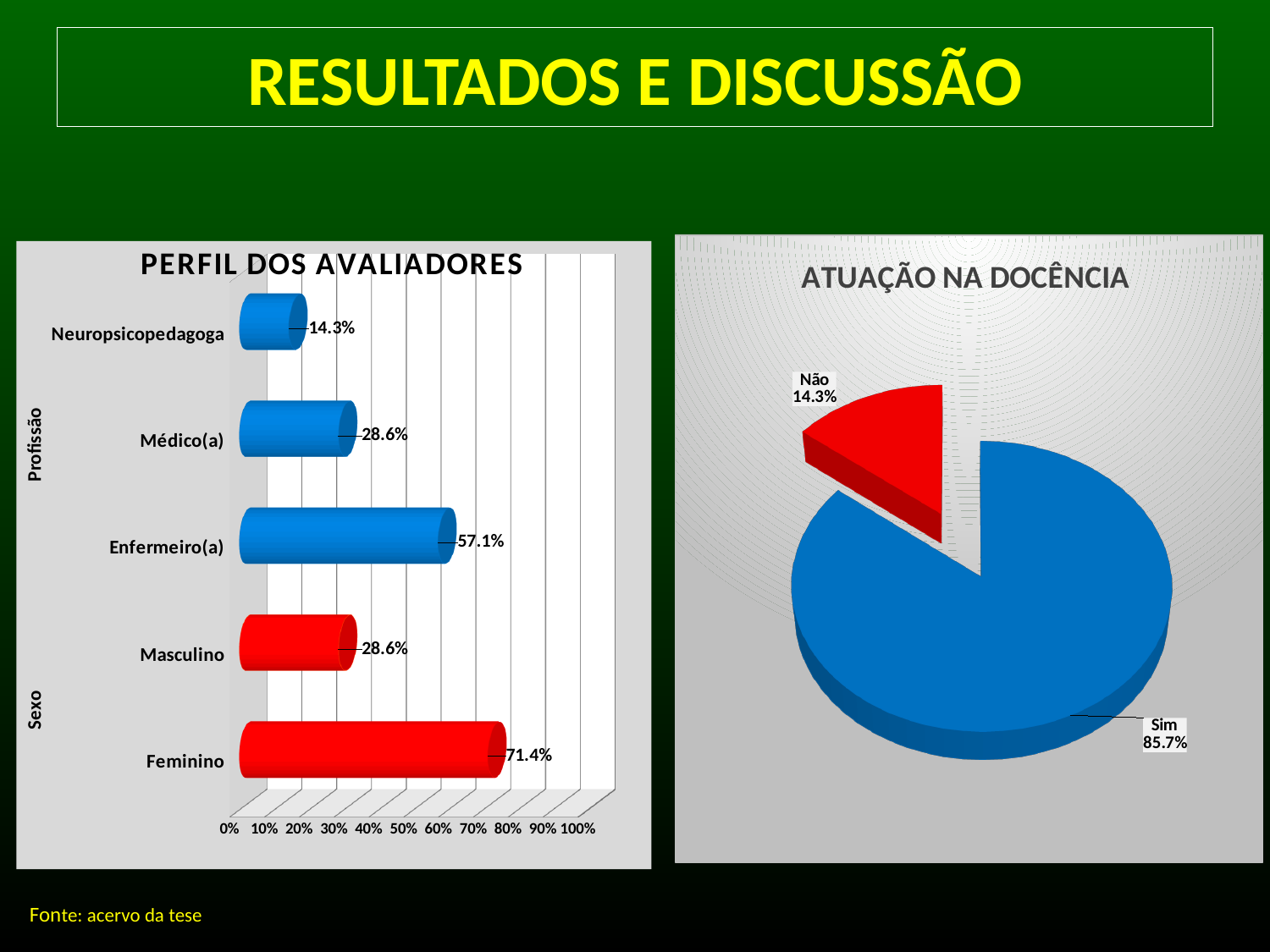
In the 'PERFIL DOS AVALIADORES' chart, which category has the lowest value? Neuropsicopedagoga In the 'PERFIL DOS AVALIADORES' chart, which is larger, Enfermeiro(a) or Médico(a)? Enfermeiro(a) In the 'PERFIL DOS AVALIADORES' chart, what is the value for Enfermeiro(a)? 57.1% In the 'ATUAÇÃO NA DOCÊNCIA' chart, what is the value for 'Não'? 14.3% In the 'PERFIL DOS AVALIADORES' chart, what is the difference between Feminino and Masculino? 42.8% In the 'PERFIL DOS AVALIADORES' chart, which category has the highest value? Feminino In the 'PERFIL DOS AVALIADORES' chart, what is the value for Neuropsicopedagoga? 14.3% In the 'PERFIL DOS AVALIADORES' chart, what is the value for Feminino? 71.4% How many categories are shown in the 'PERFIL DOS AVALIADORES' chart? 5 What kind of chart is 'PERFIL DOS AVALIADORES'? Bar chart What kind of chart is 'ATUAÇÃO NA DOCÊNCIA'? Pie chart In the 'ATUAÇÃO NA DOCÊNCIA' chart, what share does 'Sim' have? 85.7%